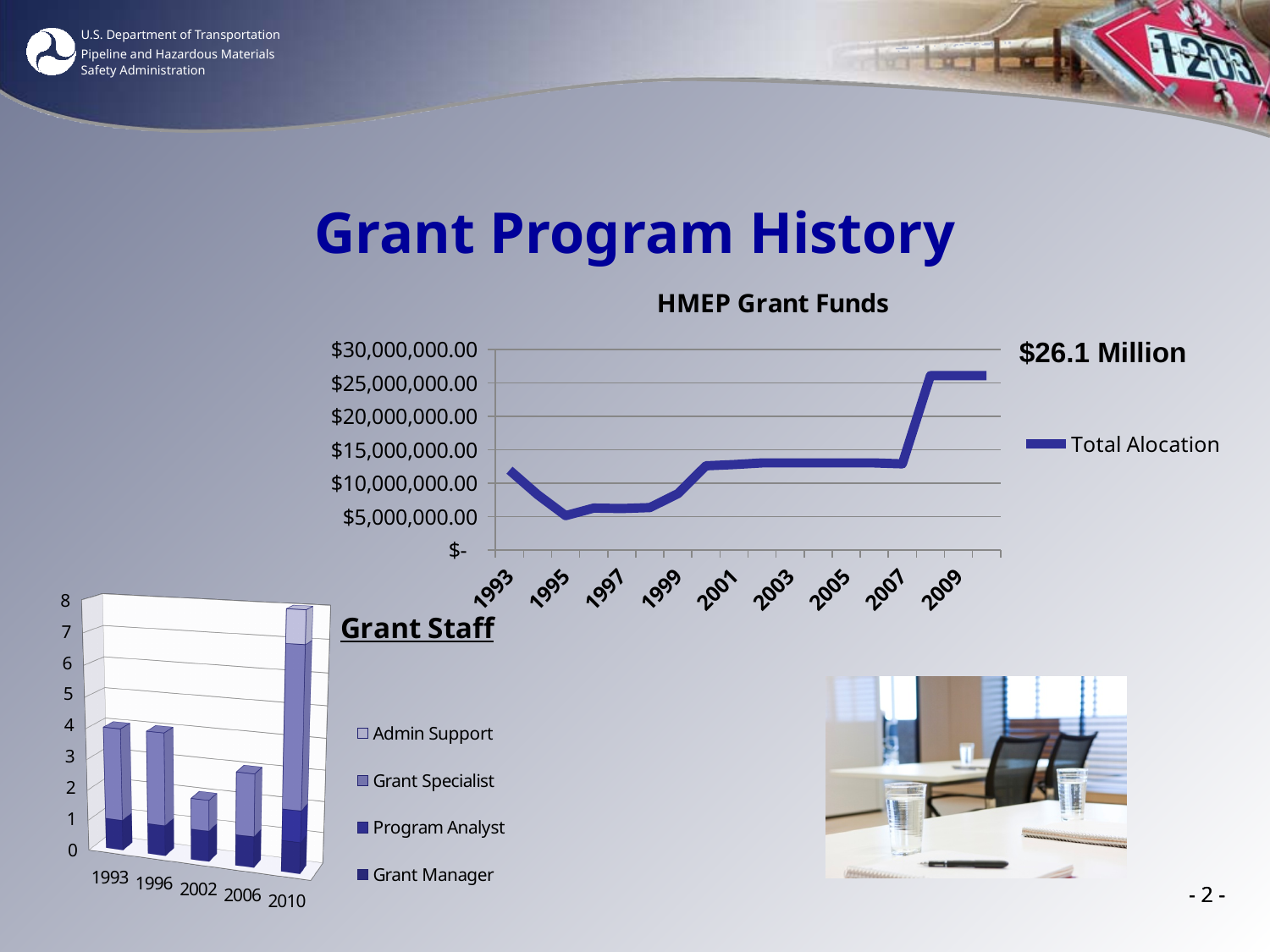
In the Grant Staff chart, which year has the shortest stacked bar? 2002 How many series does the legend of the Grant Staff chart list? 4 In the HMEP Grant Funds chart, which year has the lowest total allocation? 1995 In the HMEP Grant Funds chart, is the value for 2009 greater or less than $25,000,000.00? greater In the HMEP Grant Funds chart, does the total allocation rise or fall between 2007 and 2009? rise What kind of chart is the HMEP Grant Funds chart? line chart What kind of chart is the Grant Staff chart at the bottom left? bar chart How many years are shown on the x axis of the Grant Staff chart? 5 How many series does the legend of the HMEP Grant Funds chart list? 1 In the Grant Staff chart, which year has the tallest stacked bar? 2010 In the HMEP Grant Funds chart, is the value for 1997 greater or less than $10,000,000.00? less In the HMEP Grant Funds chart, which year has the larger value, 1997 or 2001? 2001